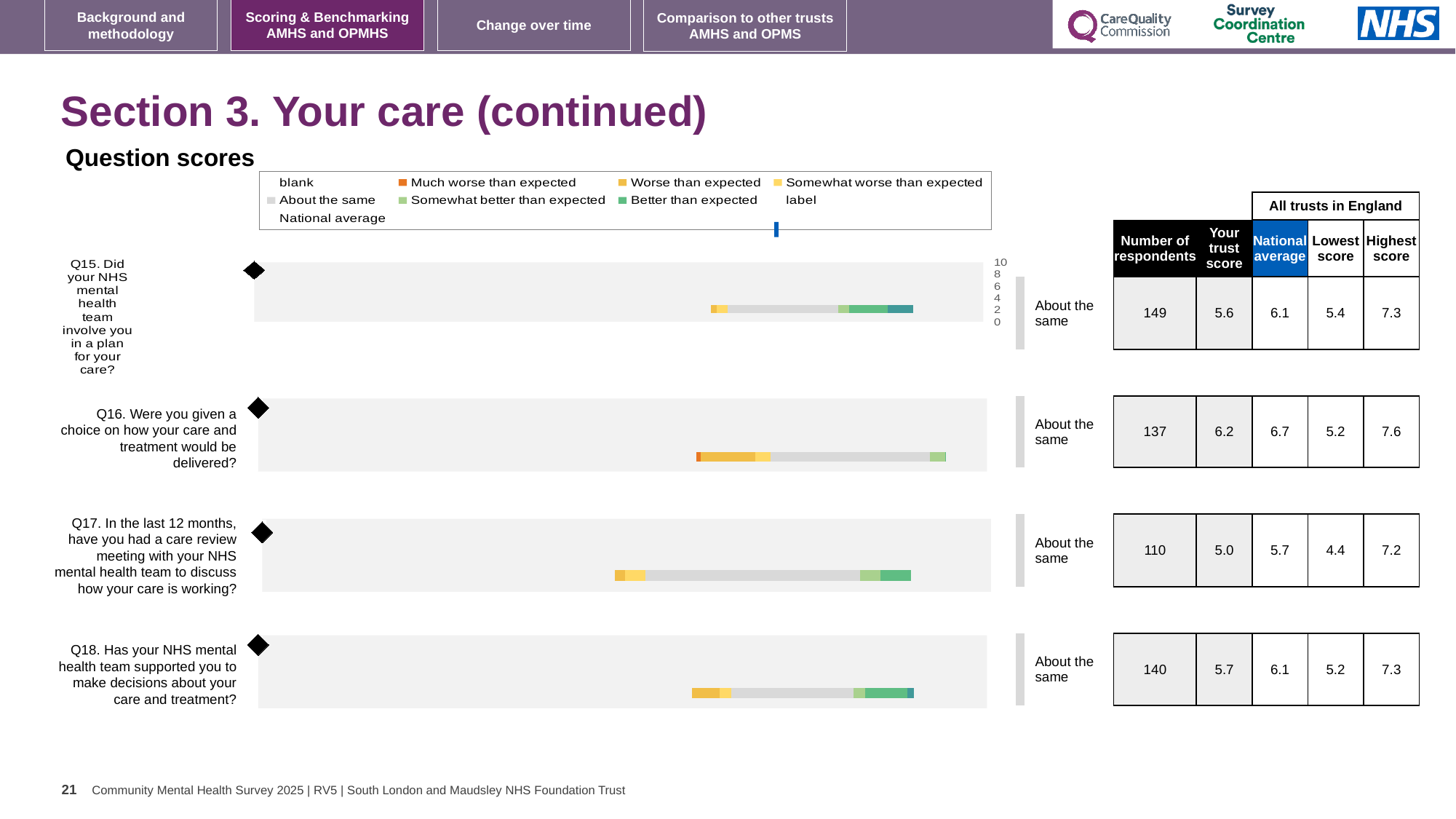
What comparison category is shown next to the bar for Q16? About the same Which legend entry is shown with a dark orange colour? Much worse than expected What is the difference between the national average and the trust score for Q16? 0.5 What is the 'Your trust score' value for Q15 in the table beside the chart? 5.6 How many questions (Q15 to Q18) have a score bar plotted on the slide? 4 Which question has the highest number of respondents? Q15 Which question has the lowest 'Your trust score' in the table? Q17 Which has the larger trust score, Q16 or Q18? Q16 What is the highest score across all trusts in England for Q16? 7.6 What is the national average for Q17 shown in the table beside the chart? 5.7 How many respondents are listed for Q18? 140 What type of chart is used to show the question scores for Q15 to Q18? bar chart